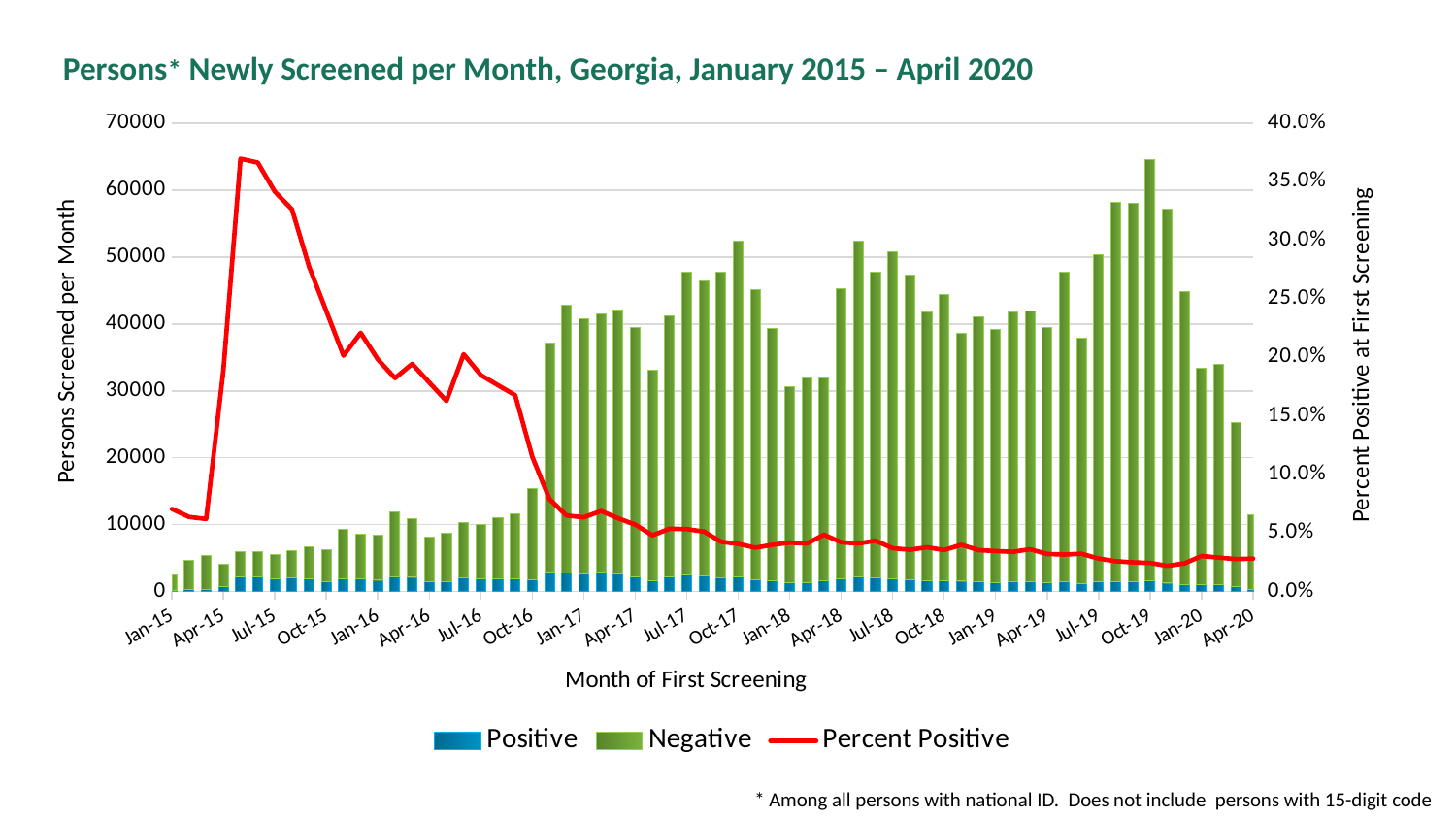
Is the Percent Positive value for Apr-20 greater or less than 5.0%? less What is the title of the chart? Persons* Newly Screened per Month, Georgia, January 2015 – April 2020 What are the three series named in the legend? Positive, Negative, Percent Positive Is the total number of persons screened in Oct-19 greater or less than 60000? greater Which month has the shortest bar for persons screened? Jan-15 Is the total number of persons screened in Jan-15 greater or less than 10000? less Does the Percent Positive line rise or fall from Jul-15 to Apr-20? fall Which month has the tallest bar for persons screened? Oct-19 What kind of chart is shown on the slide? A combined bar and line chart Which month has the larger total of persons screened, Oct-19 or Jan-15? Oct-19 How many series does the legend list? 3